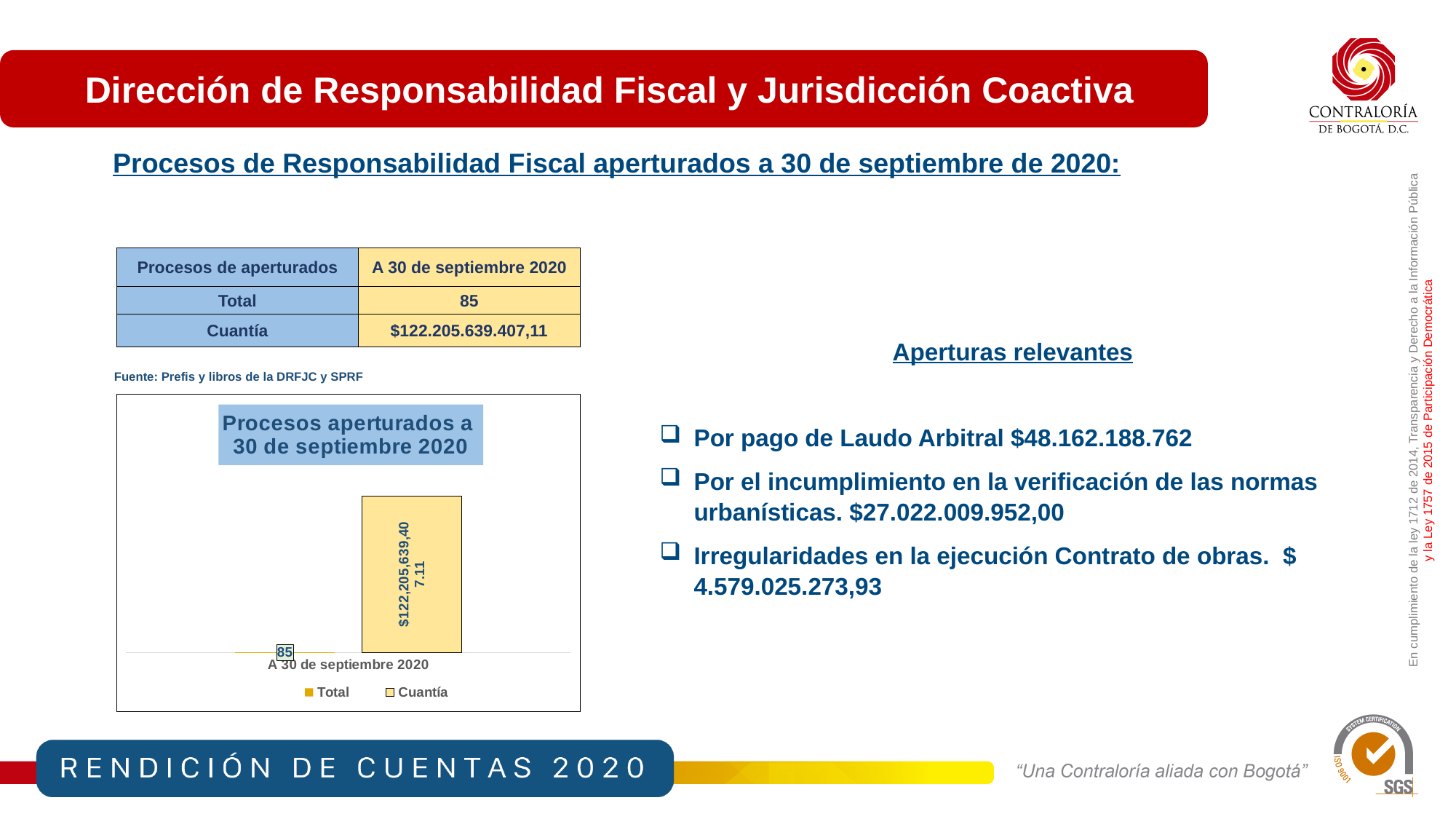
What is the title of the chart on the slide? Procesos aperturados a 30 de septiembre 2020 Which series has the smallest value in the chart? Total Which series has the larger value in the chart, Total or Cuantía? Cuantía What are the series names listed in the chart's legend? Total, Cuantía How many categories are shown on the x axis of the chart? 1 What is the value of the Total series in the chart? 85 What is the category label on the x axis of the chart? A 30 de septiembre 2020 Which series has the highest value in the chart? Cuantía How many series does the chart's legend list? 2 What is the value of the Cuantía series in the chart? $122,205,639,407.11 What kind of chart is shown on the slide? bar chart